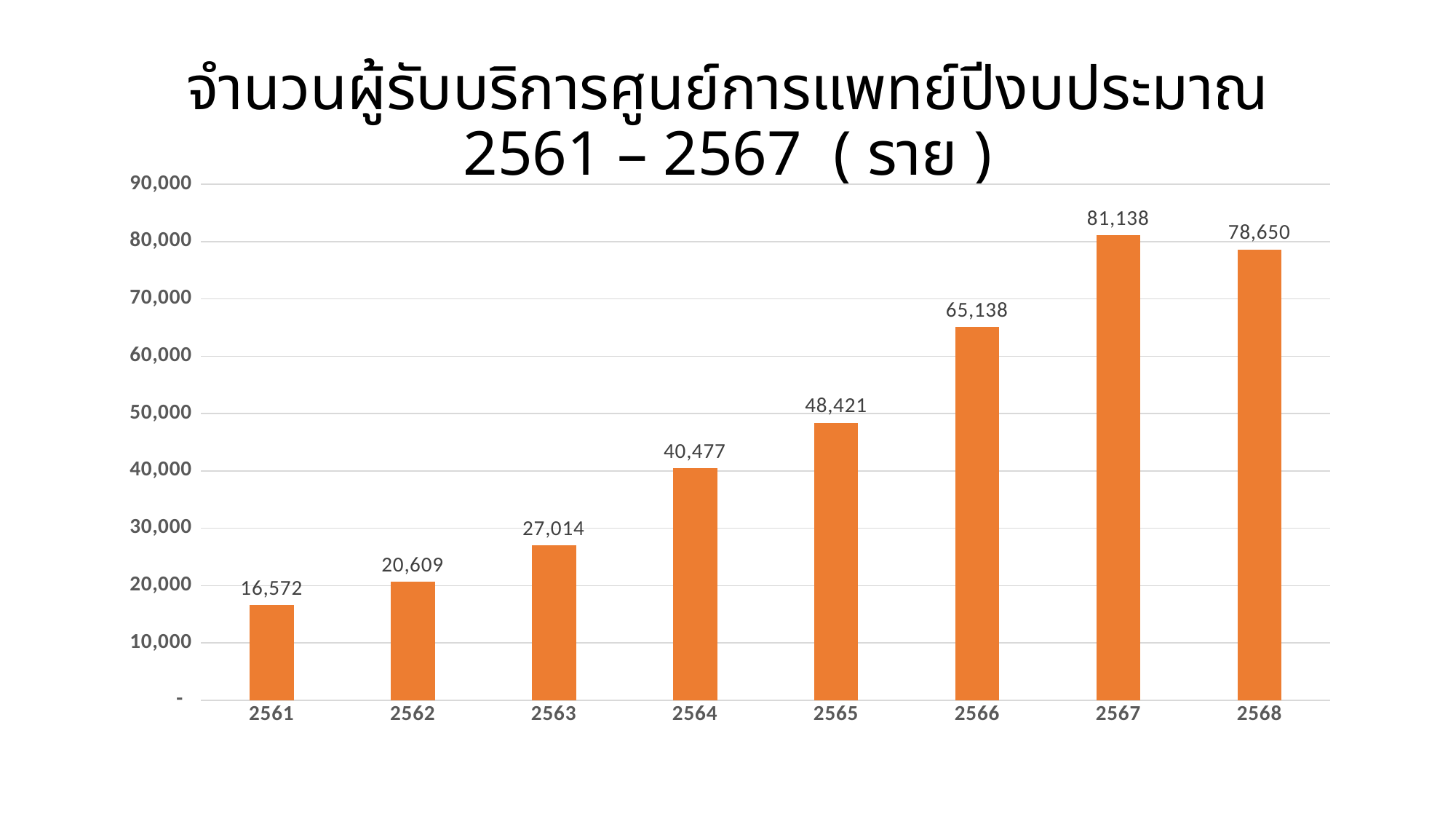
How many years are shown on the x axis? 8 What is the value for 2561? 16,572 What is the value for 2565? 48,421 What kind of chart is shown on the slide? bar chart Which is larger, the value for 2566 or the value for 2565? 2566 What is the difference between the values for 2564 and 2563? 13,463 Which year has the highest value? 2567 Do the values rise or fall from 2561 to 2567? rise What is the value for 2568? 78,650 Is the value for 2564 greater or less than 50,000? less Which year has the lowest value? 2561 What is the difference between the values for 2567 and 2568? 2,488